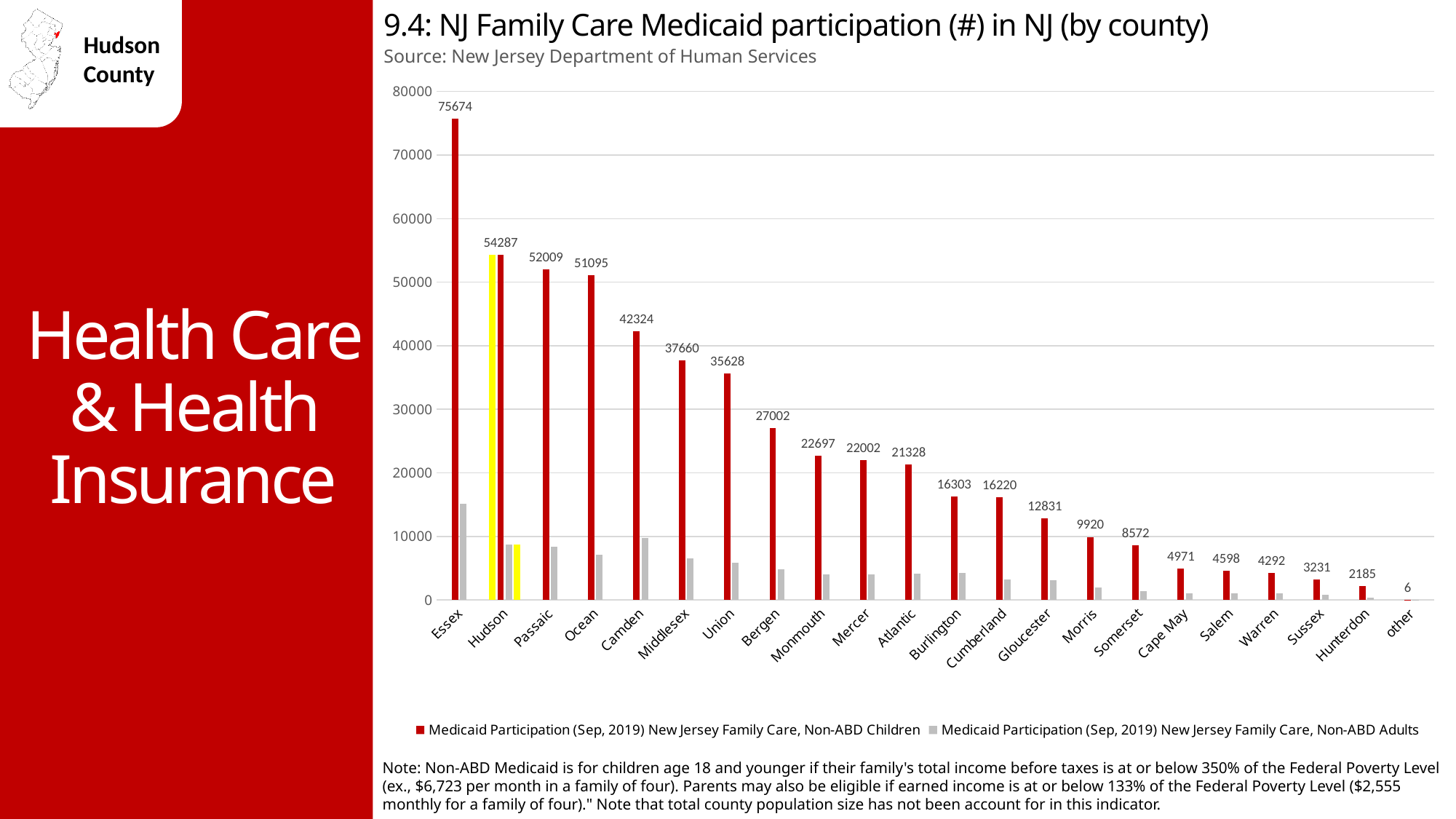
What is the Non-ABD Children Medicaid participation value for Camden? 42324 How many categories are shown on the x axis? 22 Do the Non-ABD Children values rise or fall from left to right along the x axis? fall What is the difference between the Non-ABD Children values for Essex and Hudson? 21387 Is the Non-ABD Adults value for Essex greater or less than 10000? greater What is the Non-ABD Children Medicaid participation value for Hudson? 54287 What kind of chart is shown on the slide? bar chart Which category has the lowest Non-ABD Children Medicaid participation? other Which county has the highest Non-ABD Children Medicaid participation? Essex What is the Non-ABD Children Medicaid participation value for Cape May? 4971 Which has a larger Non-ABD Children value, Bergen or Monmouth? Bergen How many series does the legend list? 2